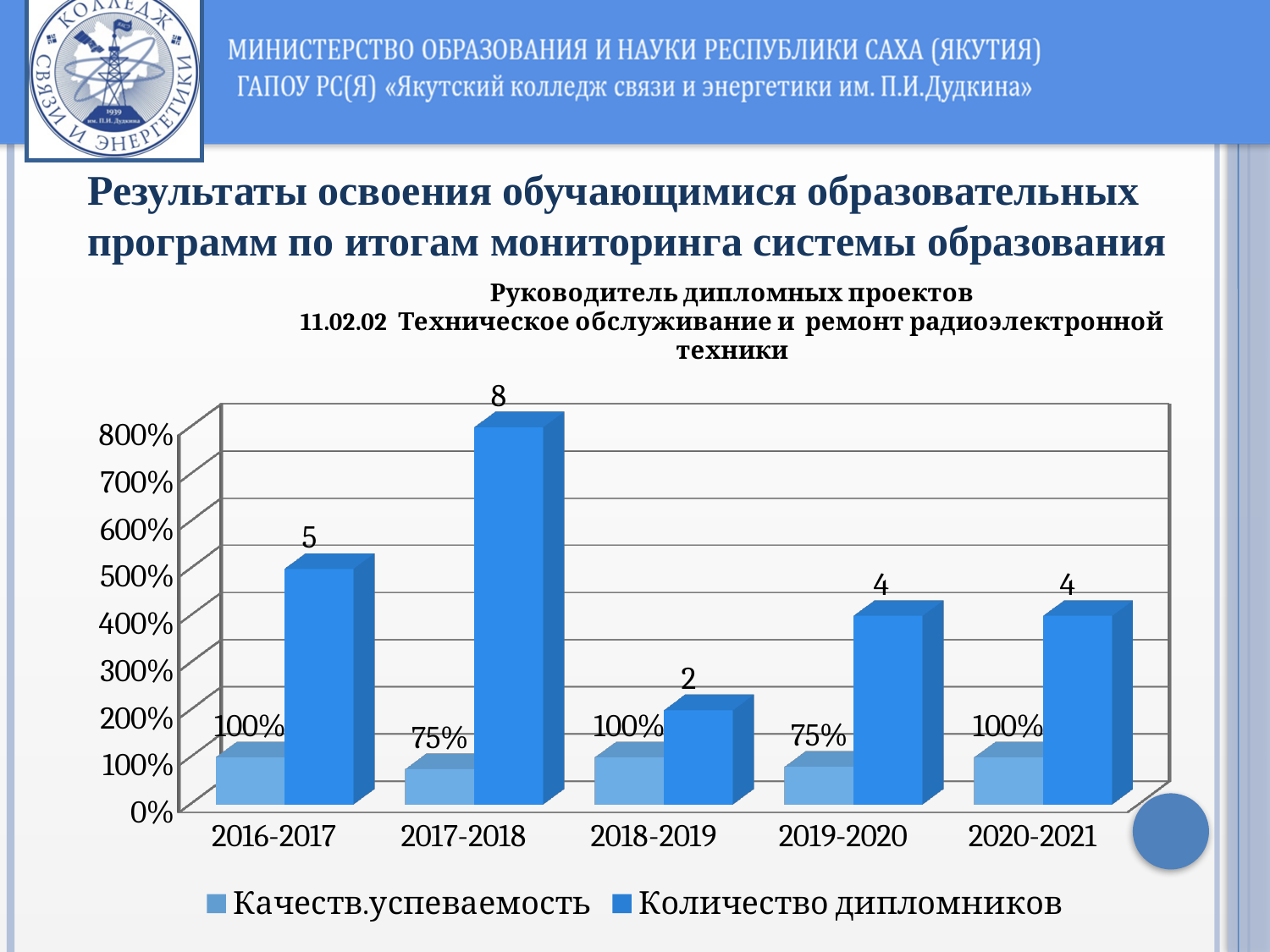
What is the value of Качеств.успеваемость for 2019-2020? 75% How many academic-year categories are shown on the x axis? 5 What is the value of Количество дипломников for 2018-2019? 2 What is the value of Количество дипломников for 2017-2018? 8 In which year is Количество дипломников highest? 2017-2018 Which series is shown in the darker blue colour in the legend? Количество дипломников What is the value of Качеств.успеваемость for 2020-2021? 100% What type of chart is shown on the slide? bar chart What is the difference in Количество дипломников between 2017-2018 and 2016-2017? 3 How many series does the legend list? 2 In which year is Количество дипломников lowest? 2018-2019 Which is larger: Количество дипломников in 2016-2017 or in 2019-2020? 2016-2017